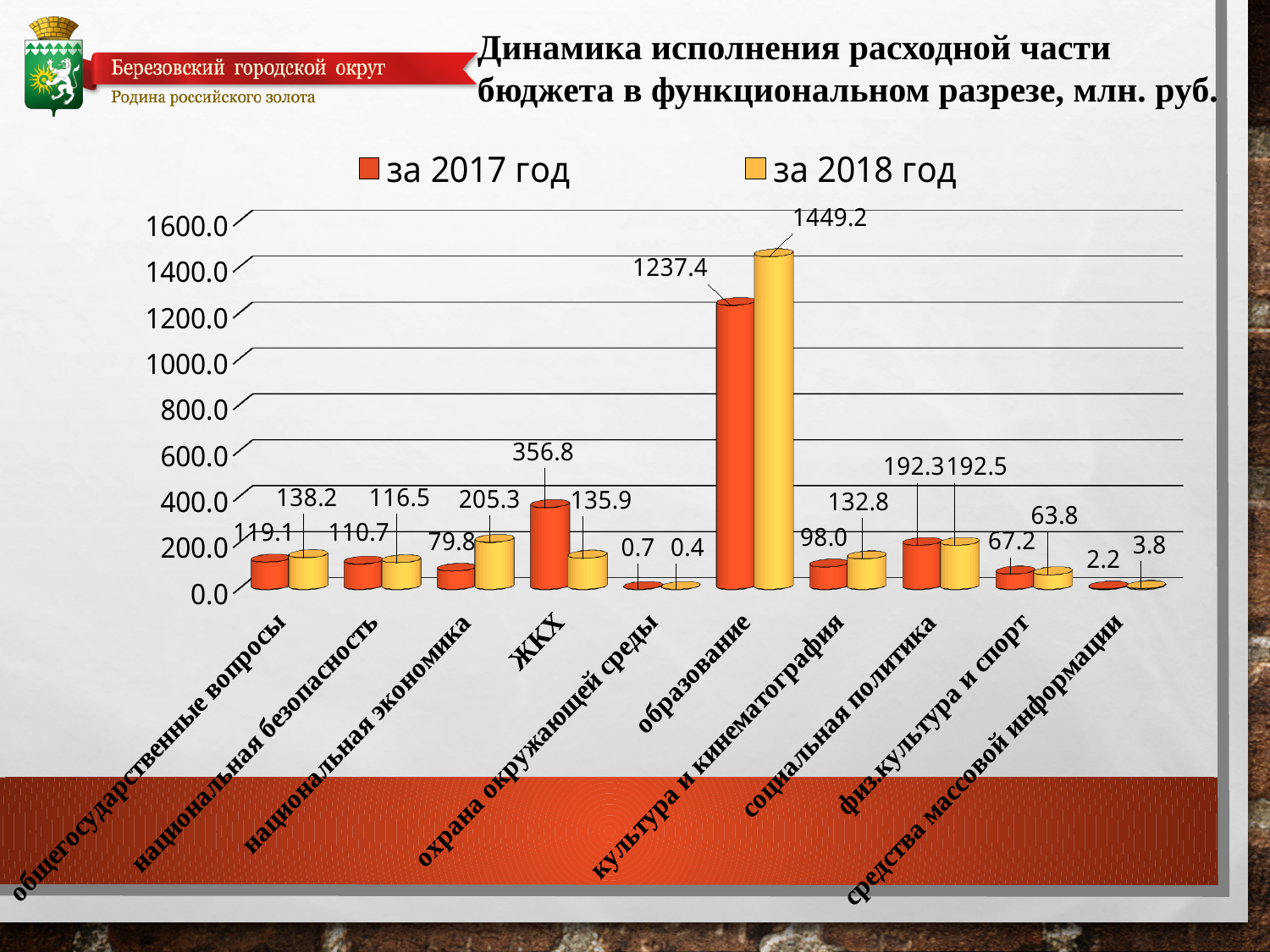
What is the value for образование for за 2018 год? 1449.2 Is the value for образование for за 2017 год greater or less than 1000.0? greater What is the difference between the за 2018 год and за 2017 год values for образование? 211.8 How many categories are shown on the x axis? 10 What is the value for ЖКХ for за 2017 год? 356.8 Which is larger for ЖКХ: the value for за 2017 год or за 2018 год? за 2017 год What are the two legend entries of the chart? за 2017 год, за 2018 год What type of chart is shown on the slide? bar chart Which category has the highest value for за 2017 год? образование What is the value for национальная экономика for за 2018 год? 205.3 How many series does the legend list? 2 Which category has the lowest value for за 2018 год? охрана окружающей среды